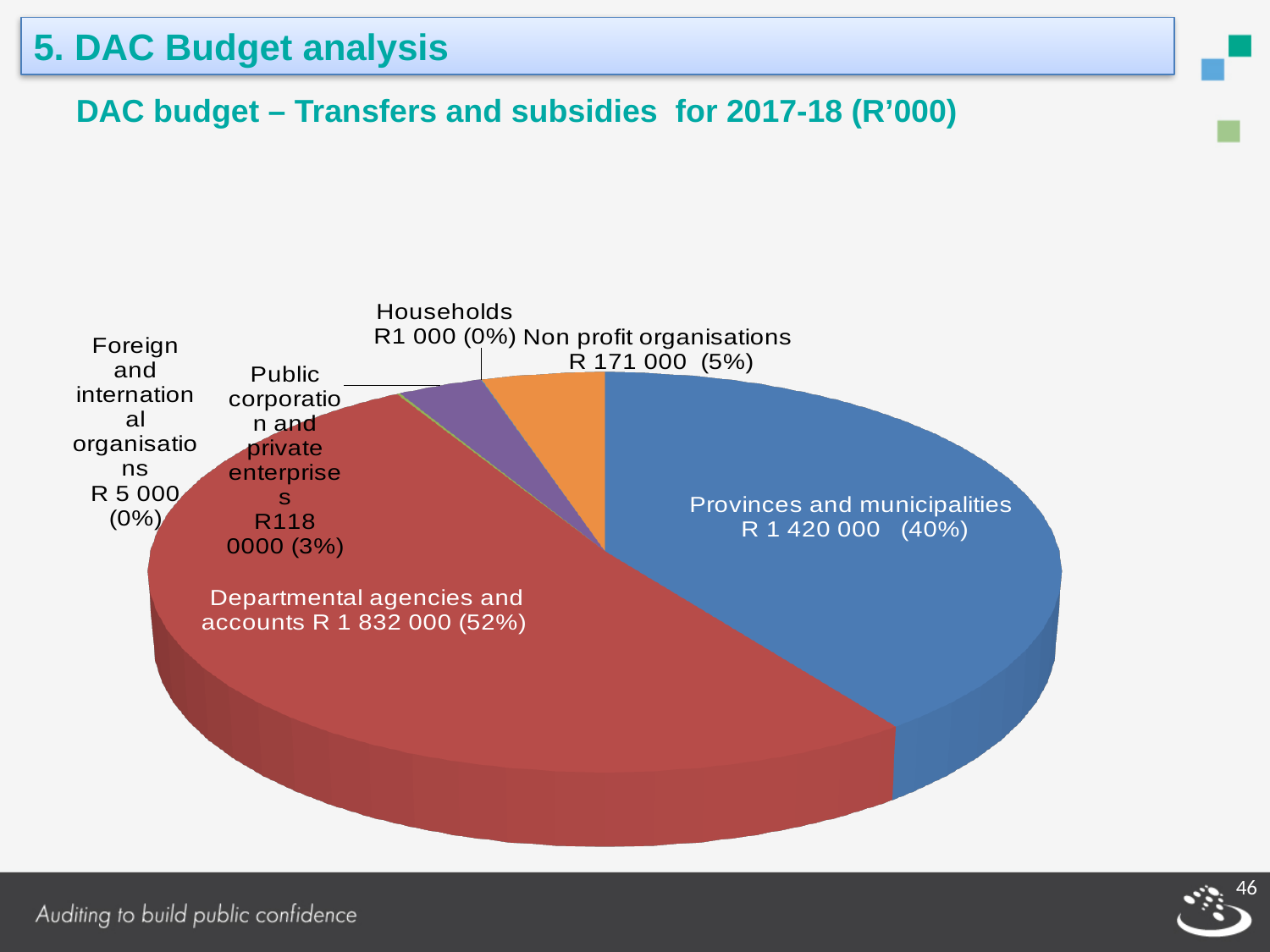
What is the difference between the values for Departmental agencies and accounts and Provinces and municipalities? R 412 000 What share of the pie does Provinces and municipalities represent? 40% Which category has the smallest value? Households What is the value for Departmental agencies and accounts? R 1 832 000 What is the value for Provinces and municipalities? R 1 420 000 How many slices does the pie chart have? 6 What kind of chart is shown on the slide? pie chart Which is larger, the value for Non profit organisations or the value for Households? Non profit organisations What is the value for Non profit organisations? R 171 000 What is the value for Foreign and international organisations? R 5 000 What share of the pie does Public corporations and private enterprises represent? 3% Which category has the largest share of the pie? Departmental agencies and accounts